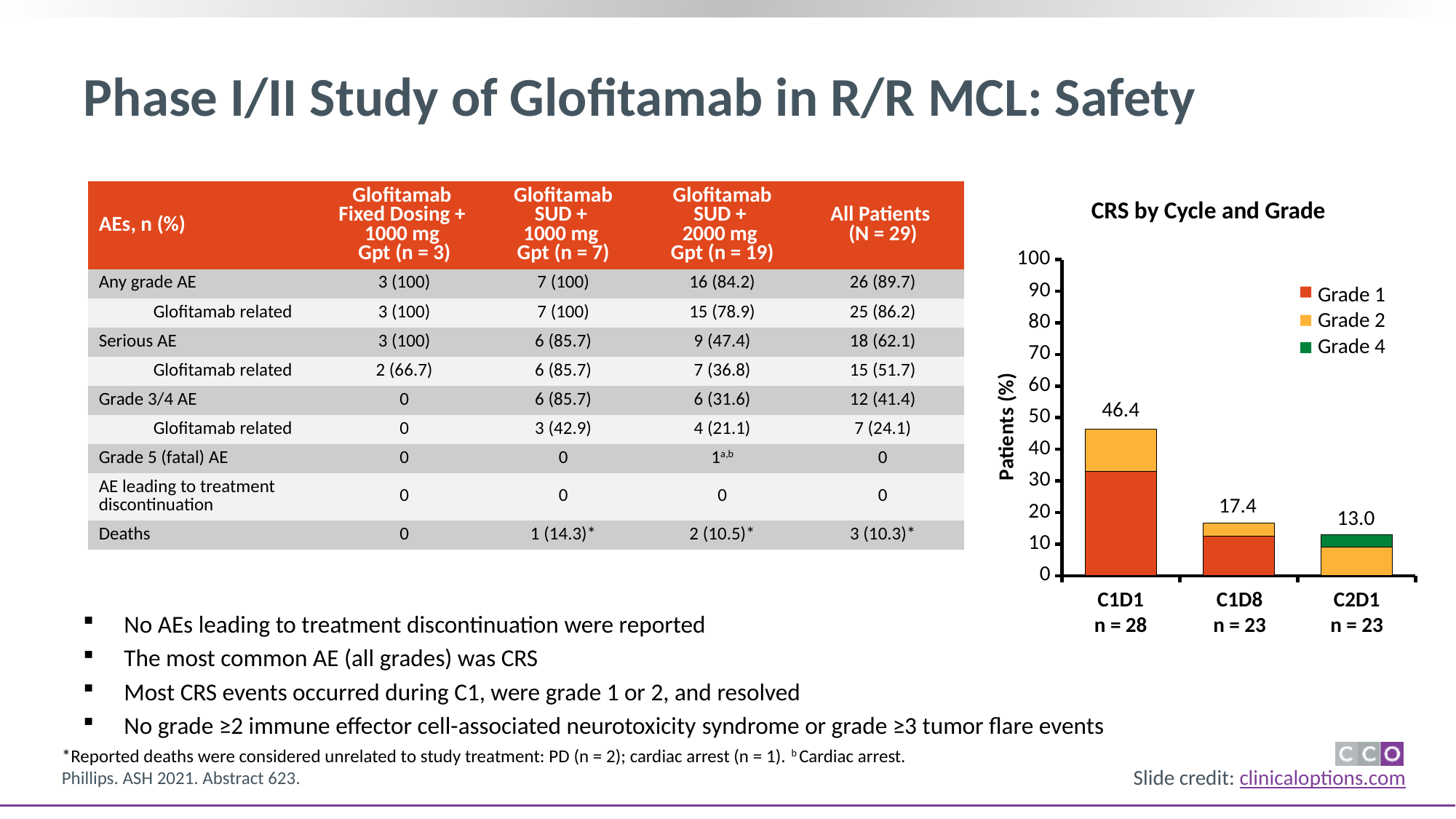
In the CRS by Cycle and Grade chart, what is the difference between the total CRS rate at C1D1 and at C1D8? 29.0 How many grades does the legend of the CRS by Cycle and Grade chart list? 3 In the CRS by Cycle and Grade chart, is the Grade 1 portion of the C1D1 bar greater or less than 20? greater In the CRS by Cycle and Grade chart, is the total CRS rate higher at C1D8 or at C2D1? C1D8 In the CRS by Cycle and Grade chart, what is the total percentage of patients with CRS at C2D1? 13.0 How many cycle/day categories are shown on the x axis of the CRS by Cycle and Grade chart? 3 In the CRS by Cycle and Grade chart, which cycle/day has the lowest total CRS rate? C2D1 In the CRS by Cycle and Grade chart, what is the total percentage of patients with CRS at C1D1? 46.4 In the CRS by Cycle and Grade chart, do the total CRS rates rise or fall from C1D1 to C2D1? Fall In the CRS by Cycle and Grade chart, which cycle/day has the highest total CRS rate? C1D1 What type of chart is the CRS by Cycle and Grade chart? Stacked bar chart In the CRS by Cycle and Grade chart, what is the total percentage of patients with CRS at C1D8? 17.4